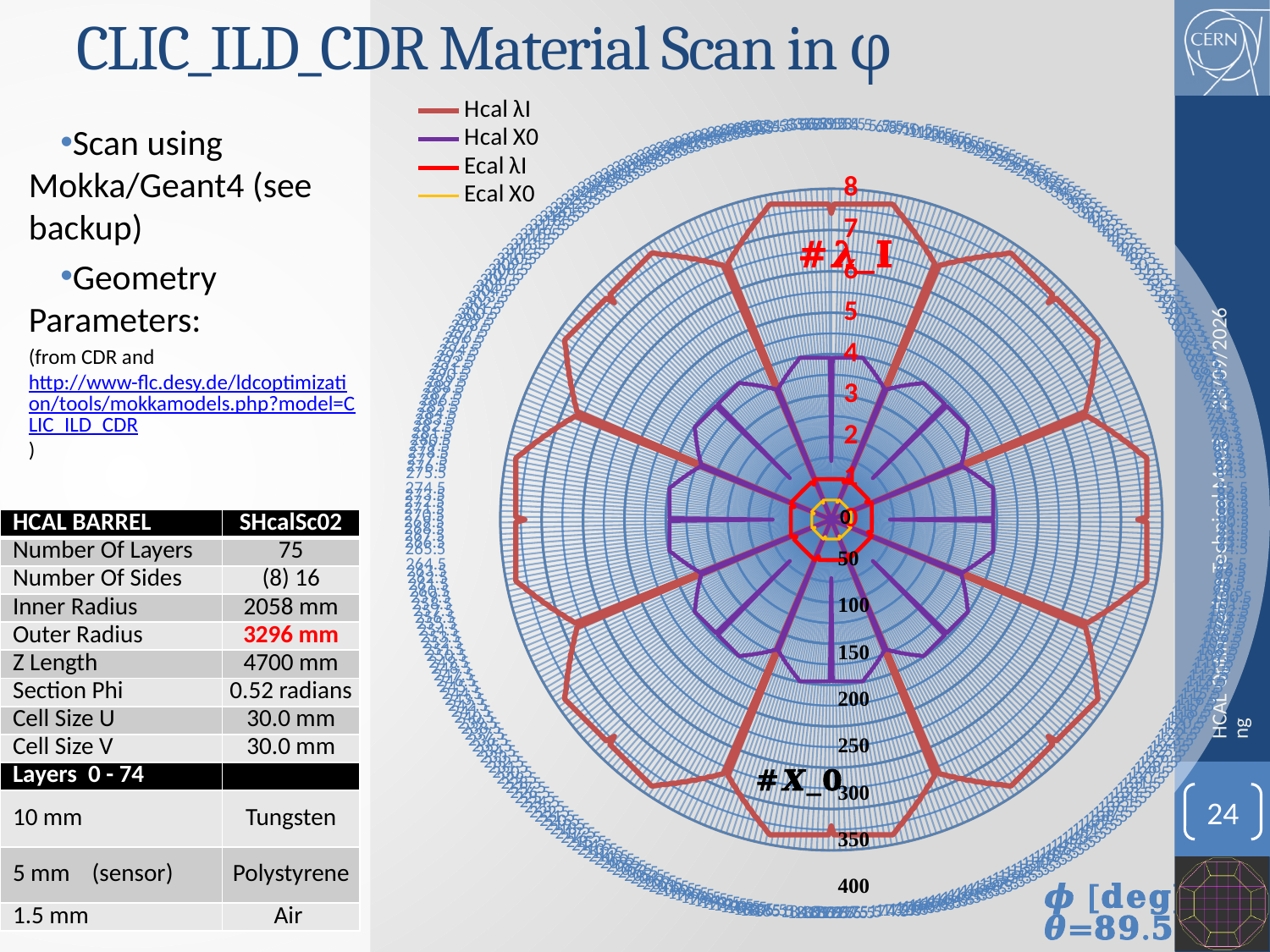
How many series does the legend of the material scan chart list? 4 Which series is drawn in yellow on the chart? Ecal X0 Which series extends farther from the centre, Hcal X0 or Ecal X0? Hcal X0 What kind of chart is the material scan in φ? radar chart Which series extends farther from the centre, Hcal λI or Ecal λI? Hcal λI Which series is drawn in purple on the chart? Hcal X0 Which series stays closest to the centre of the chart? Ecal X0 Which series extends farthest from the centre of the chart? Hcal λI